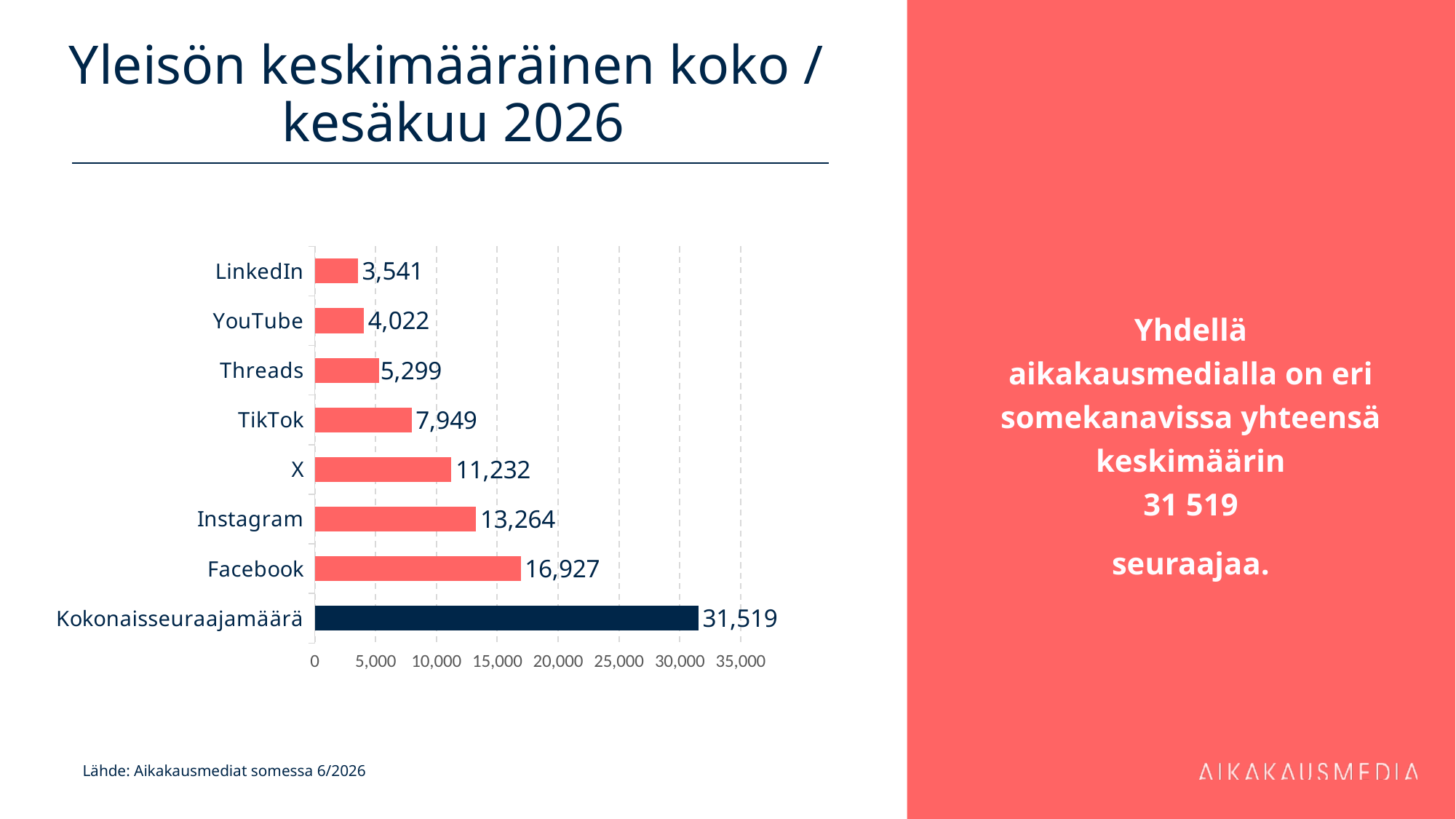
Which category has the lowest value? LinkedIn What is the difference between the values for YouTube and LinkedIn? 481 Is the value for Instagram greater or less than 15,000? less What is the value for TikTok? 7,949 What kind of chart is shown on the slide? bar chart What is the value for Facebook? 16,927 What is the value for Kokonaisseuraajamäärä? 31,519 How many categories are shown in the chart? 8 Which is larger, the value for X or the value for Threads? X Which bar is shown in a different colour (dark navy) from the others? Kokonaisseuraajamäärä Which category has the highest value? Kokonaisseuraajamäärä What is the difference between the values for Facebook and Instagram? 3,663